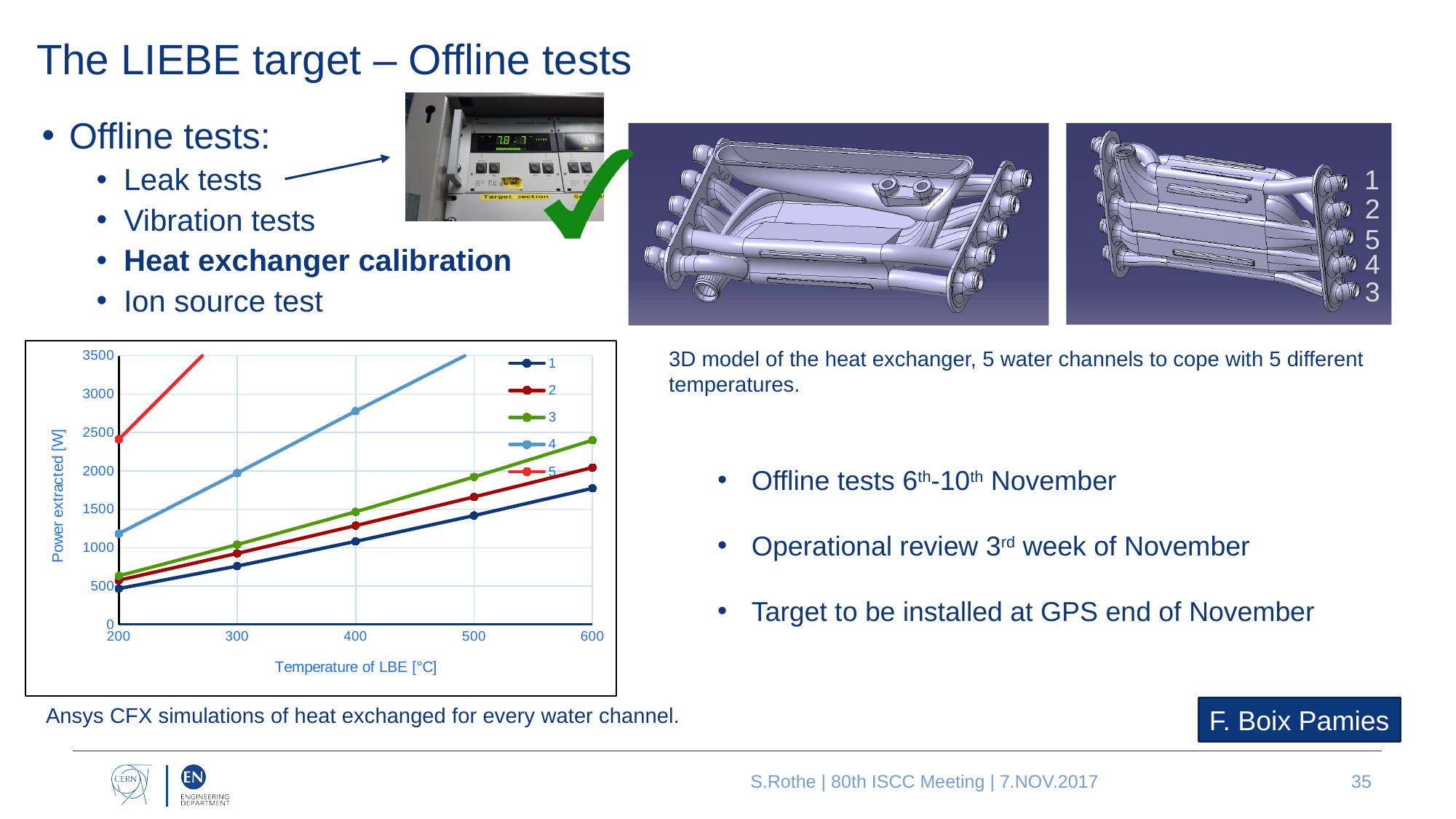
What kind of chart is shown on the slide? line chart Do the values of series 1 rise or fall as the temperature of LBE increases? rise How many series does the chart legend list? 5 At 400 °C, which series has the larger power extracted, series 4 or series 1? 4 Which series has the highest power extracted at 200 °C? 5 Is the value for series 5 at 200 °C greater or less than 2000 W? greater Is the value for series 4 at 400 °C greater or less than 2500 W? greater At 600 °C, which series has the larger power extracted, series 3 or series 2? 3 What is the label of the y axis of the chart? Power extracted [W] Is the value for series 1 at 600 °C greater or less than 2000 W? less Which series has the lowest power extracted at 200 °C? 1